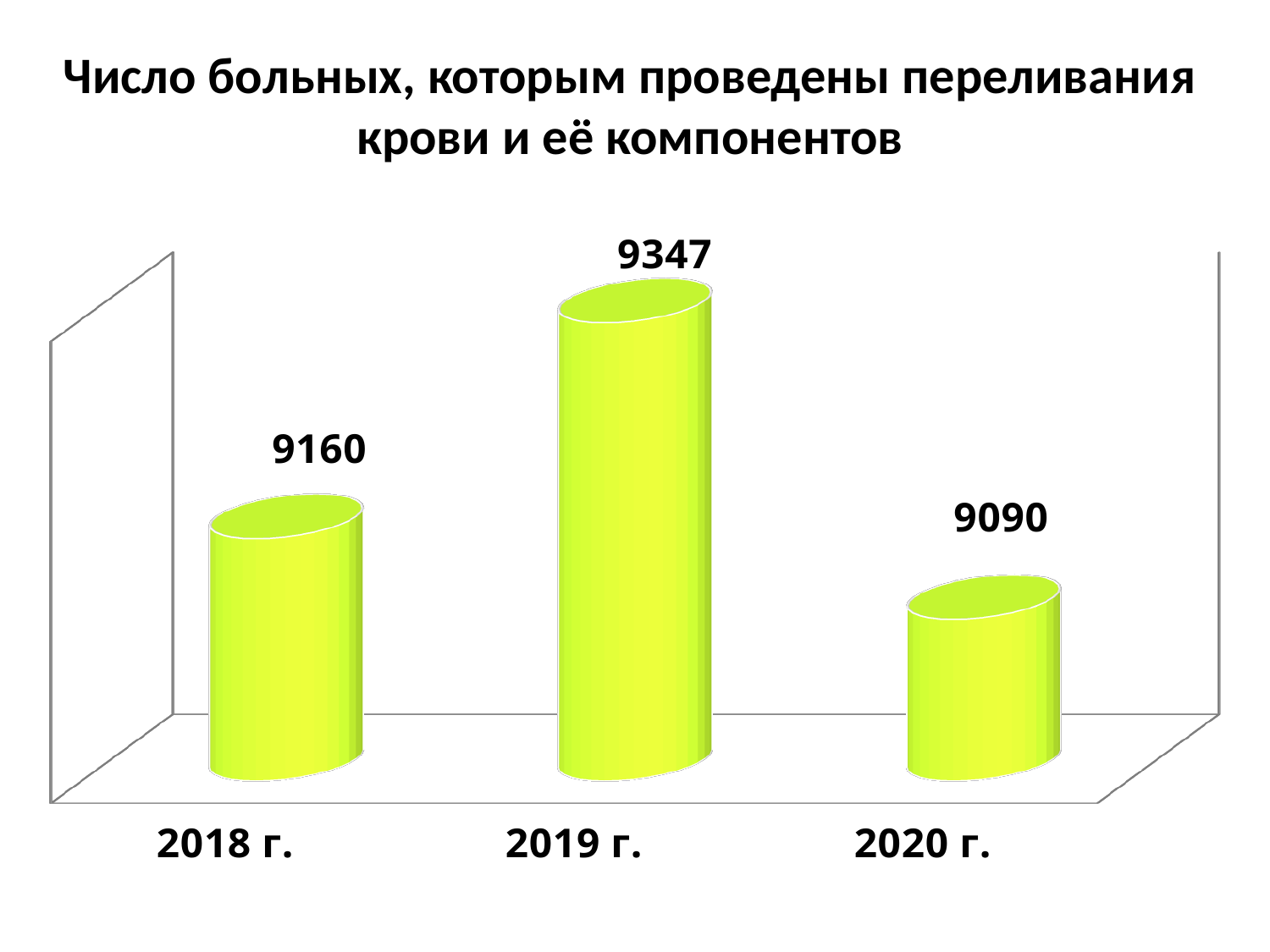
What is the difference between the values for 2019 г. and 2018 г.? 187 What is the difference between the values for 2018 г. and 2020 г.? 70 What kind of chart is shown on the slide? bar chart Which year has the lowest value? 2020 г. What is the value for 2020 г.? 9090 Which is larger, the value for 2018 г. or the value for 2020 г.? 2018 г. What is the value for 2018 г.? 9160 How many years are shown on the chart? 3 What is the difference between the values for 2019 г. and 2020 г.? 257 What is the title of the chart? Число больных, которым проведены переливания крови и её компонентов Which year has the highest value? 2019 г. What is the value for 2019 г.? 9347